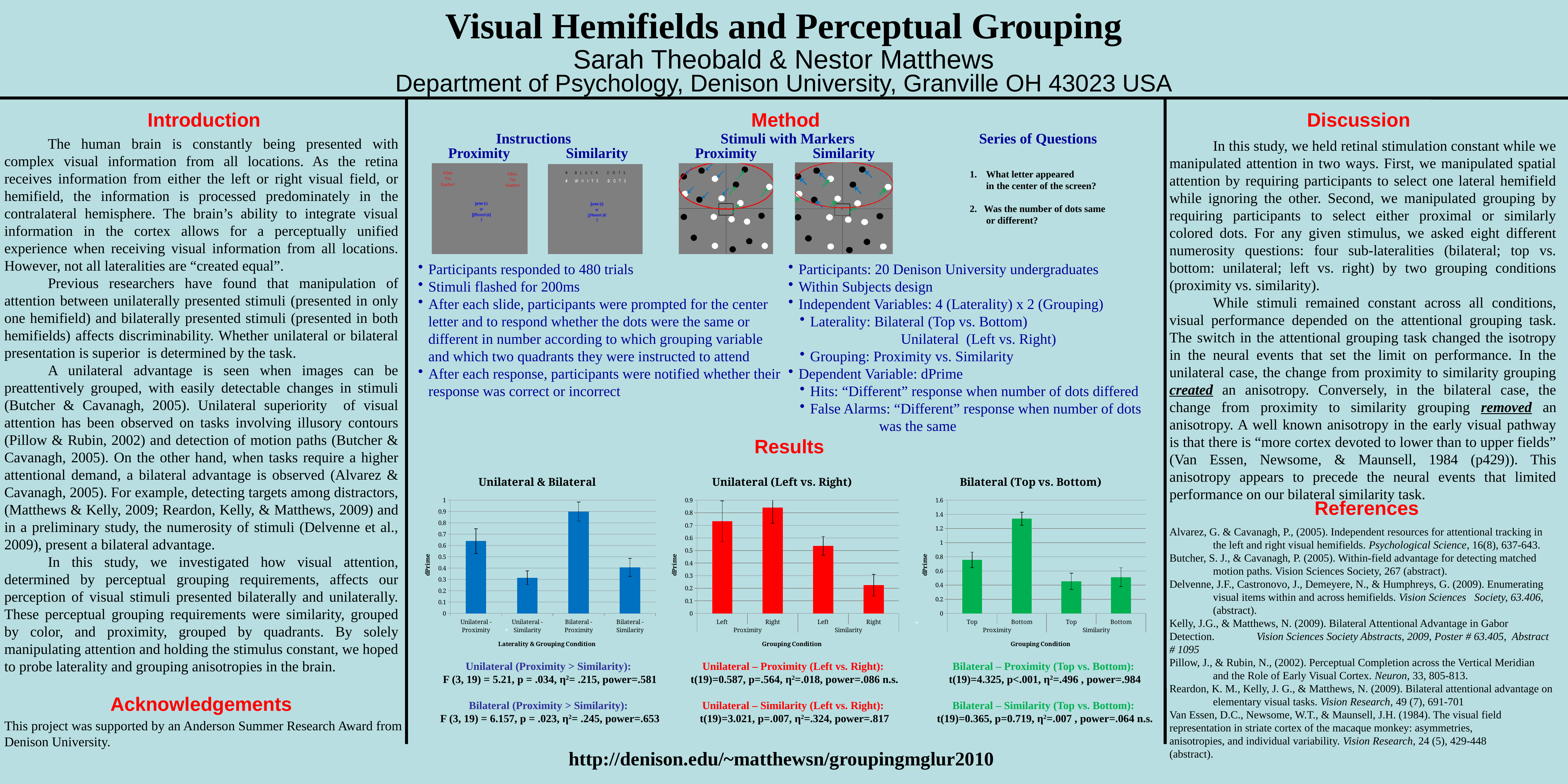
In the 'Unilateral (Left vs. Right)' chart, which is larger: Left Similarity or Right Similarity? Left Similarity In the 'Bilateral (Top vs. Bottom)' chart, is the value for Bottom Proximity greater or less than 1.2? greater What is the x-axis title of the 'Unilateral & Bilateral' chart? Laterality & Grouping Condition In the 'Unilateral & Bilateral' chart, which category has the highest dPrime? Bilateral - Proximity In the 'Unilateral (Left vs. Right)' chart, is the value for Right Proximity greater or less than 0.8? greater In the 'Unilateral & Bilateral' chart, how many bars are plotted? 4 In the 'Unilateral (Left vs. Right)' chart, which bar is the lowest? Right (Similarity) In the 'Bilateral (Top vs. Bottom)' chart, which is larger: Top Proximity or Bottom Proximity? Bottom Proximity In the 'Bilateral (Top vs. Bottom)' chart, which bar is the highest? Bottom (Proximity) What type of chart is the 'Unilateral (Left vs. Right)' chart? bar chart In the 'Unilateral & Bilateral' chart, is the value for Unilateral - Proximity greater or less than 0.5? greater In the 'Unilateral & Bilateral' chart, which category has the lowest dPrime? Unilateral - Similarity